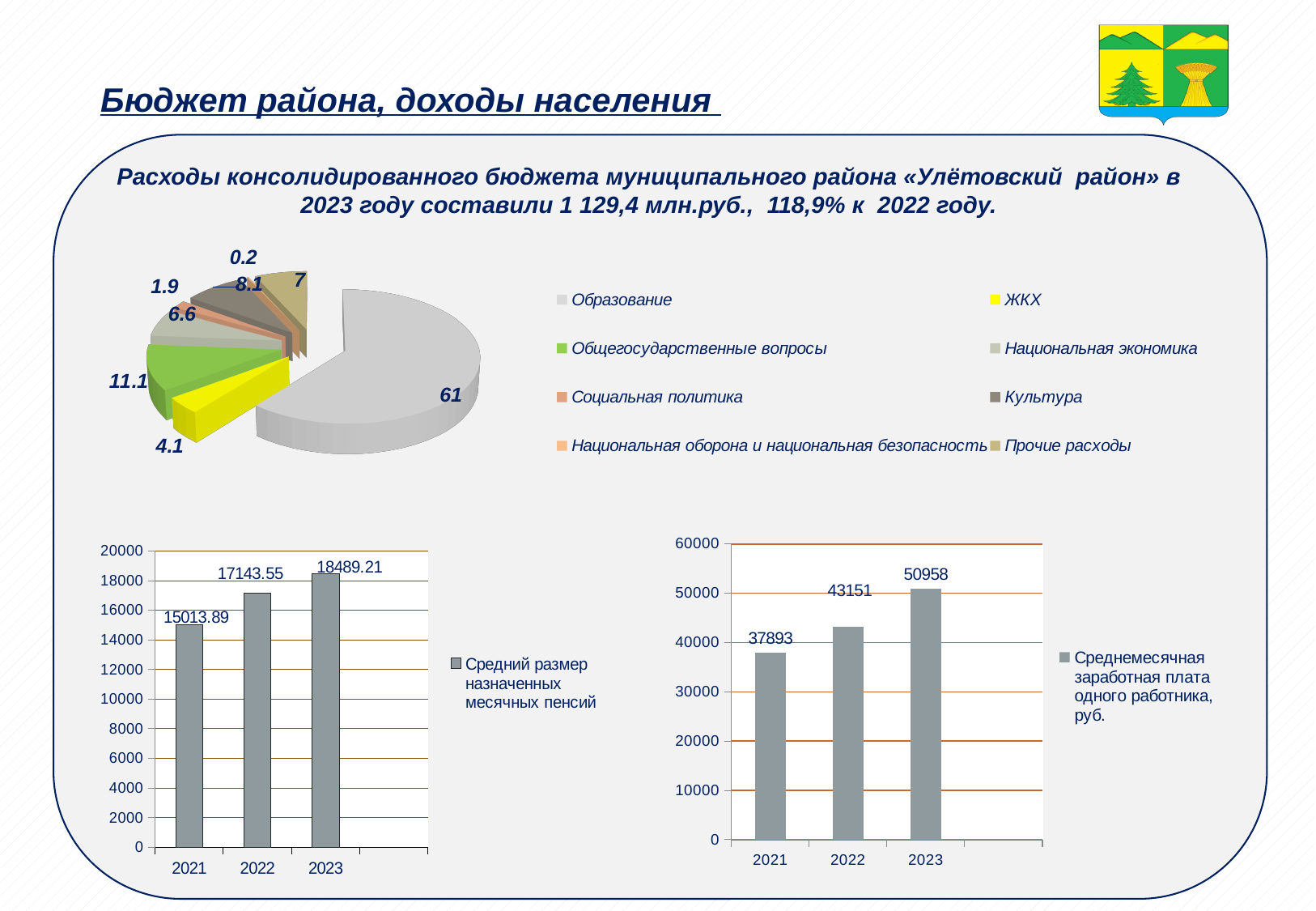
In the bottom-right chart of average monthly salary, which year has the lowest value? 2021 In the pie chart of budget expenditures, what is the value shown for the green Общегосударственные вопросы slice? 11.1 How many categories does the legend of the pie chart list? 8 In the pie chart of budget expenditures, what is the value shown for the yellow ЖКХ slice? 4.1 In the bottom-left chart of average monthly pensions, what is the value for 2023? 18489.21 In the bottom-right chart of average monthly salary, what is the value for 2022? 43151 In the bottom-left chart of average monthly pensions, what is the value for 2021? 15013.89 What kind of chart is the bottom-right chart of average monthly salary? bar chart In the pie chart of budget expenditures, which category has the largest share? Образование In the bottom-left chart of average monthly pensions, do the values rise or fall from 2021 to 2023? rise In the pie chart of budget expenditures, what is the value shown for Образование? 61 In the bottom-right chart of average monthly salary, what is the difference between 2023 and 2021? 13065